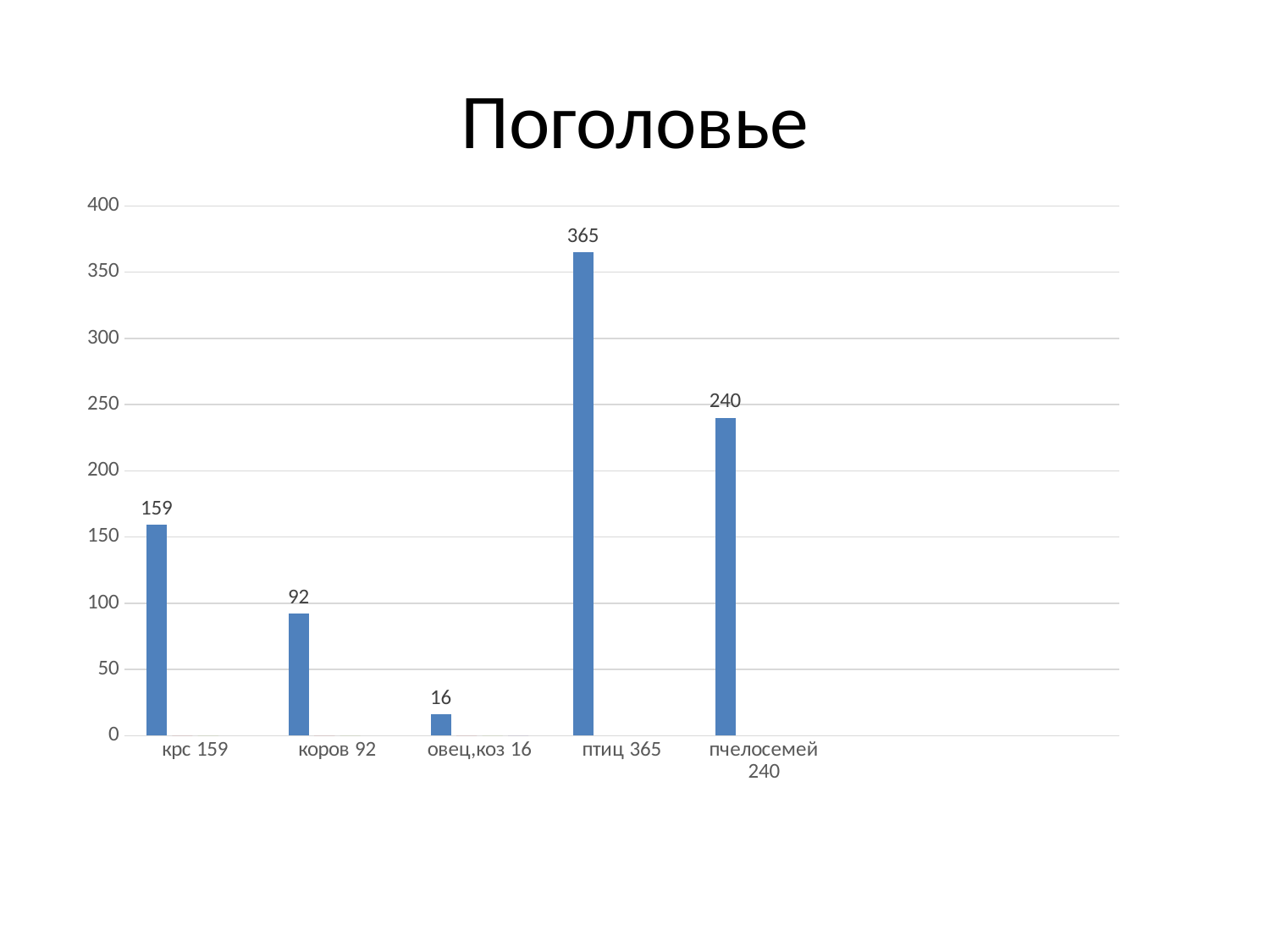
How many categories are shown in the chart? 5 What kind of chart is shown on the slide? bar chart What is the difference between the values for "птиц 365" and "пчелосемей 240"? 125 What is the difference between the values for "крс 159" and "коров 92"? 67 Is the value for "пчелосемей 240" greater or less than 200? greater Which category has the highest value? птиц 365 What is the value for "птиц 365"? 365 What is the value for "коров 92"? 92 What is the title of the slide? Поголовье Which is larger, the value for "крс 159" or the value for "коров 92"? крс 159 Which category has the lowest value? овец,коз 16 What is the value for "пчелосемей 240"? 240